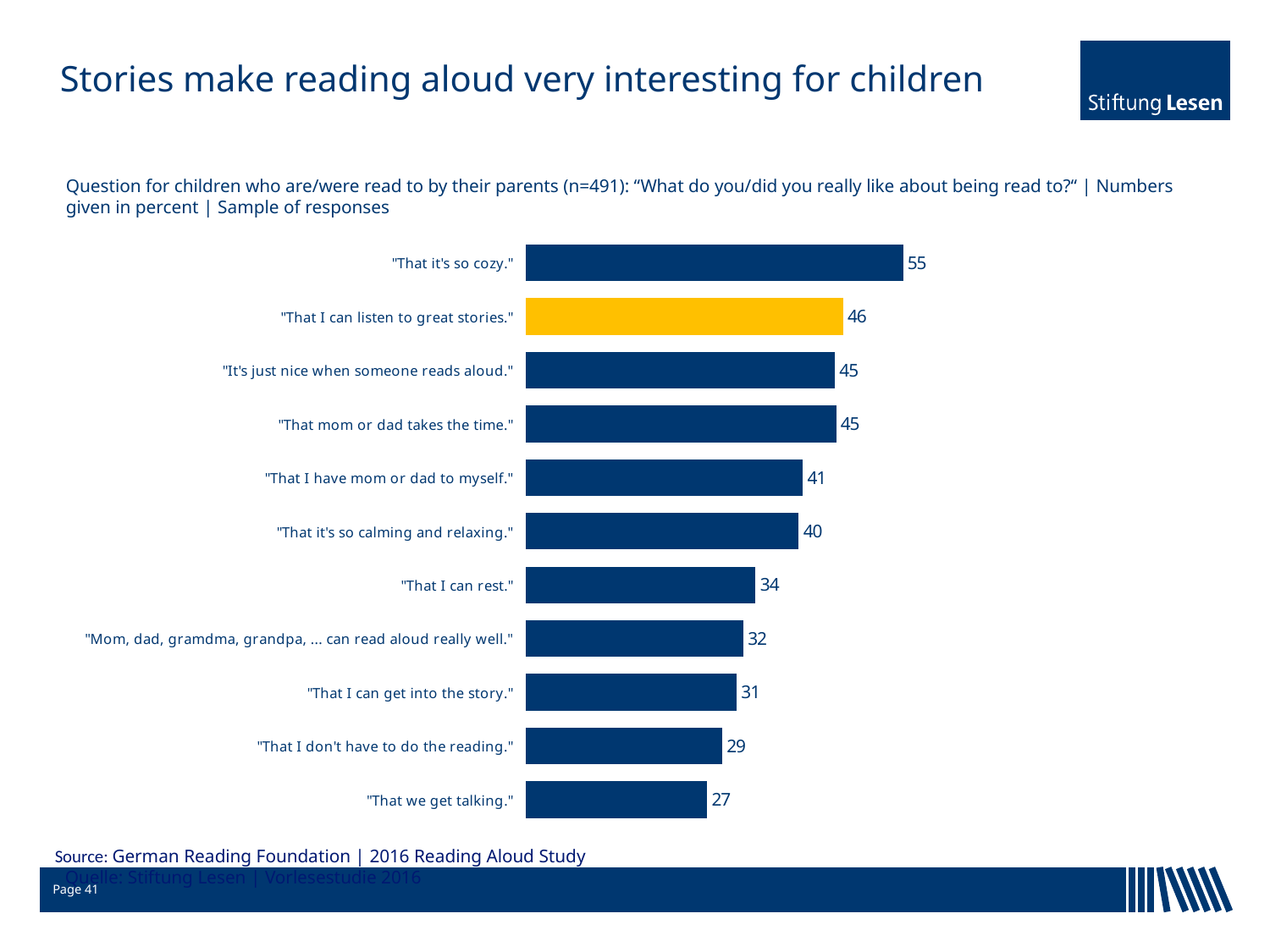
What is the difference between the values for "That it's so cozy." and "That I can listen to great stories."? 9 What is the value for "That I can listen to great stories."? 46 What is the value for "That I can rest."? 34 What kind of chart is shown on the slide? Bar chart What is the difference between the values for "That I don't have to do the reading." and "That we get talking."? 2 Which is larger: the value for "That I have mom or dad to myself." or the value for "That I can get into the story."? "That I have mom or dad to myself." Which response has the highest value? "That it's so cozy." Which response has the lowest value? "That we get talking." What is the value for "That we get talking."? 27 How many responses are shown in the chart? 11 Which bar is highlighted in yellow? "That I can listen to great stories." What is the value for "That it's so cozy."? 55